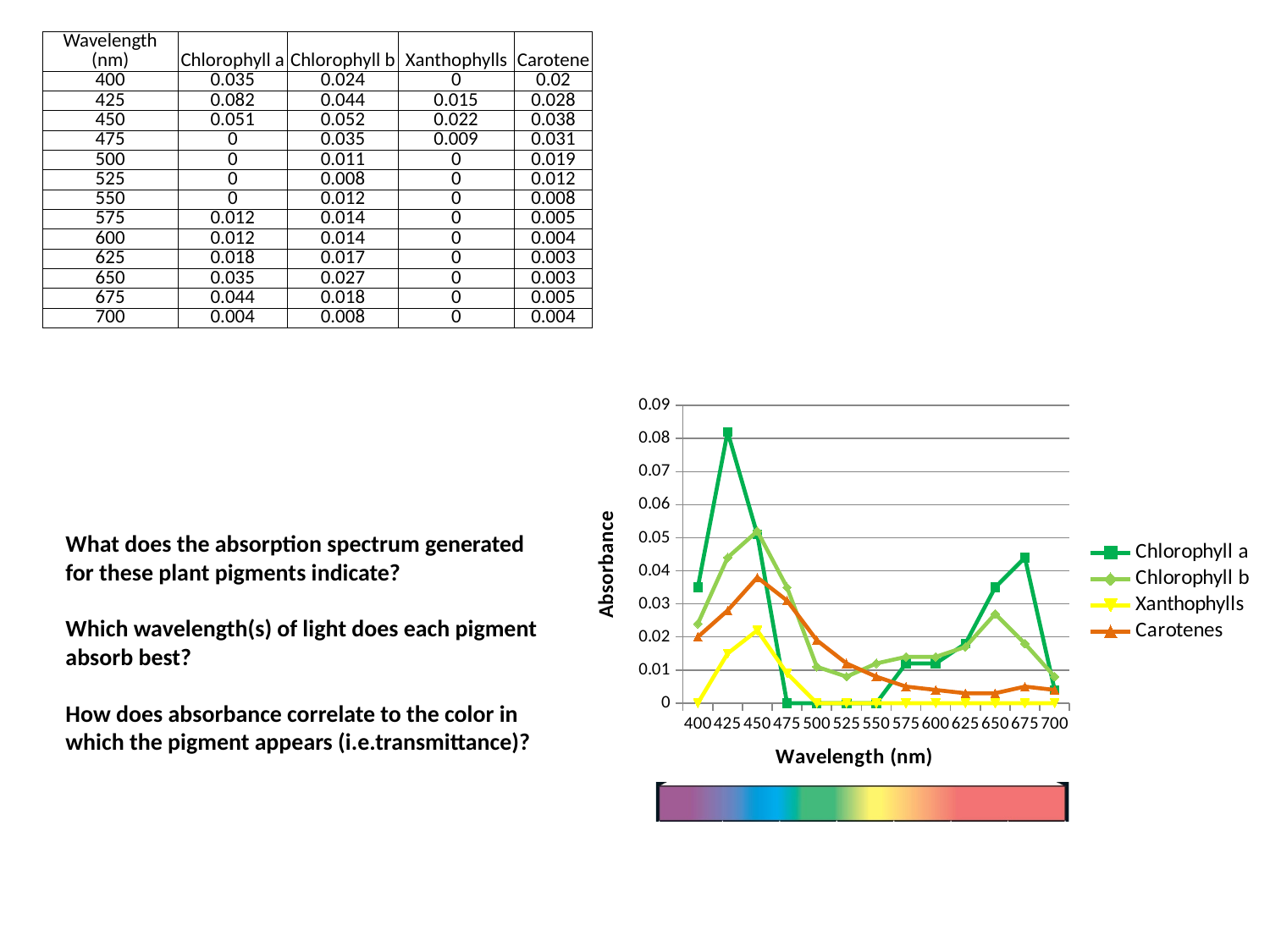
At which wavelength does Chlorophyll a reach its highest absorbance? 425 What is the absorbance of Chlorophyll a at 425 nm? 0.082 At which wavelength do Carotenes reach their highest absorbance? 450 What is the difference between the absorbance of Chlorophyll a and Chlorophyll b at 425 nm? 0.038 What is the title of the chart's vertical axis? Absorbance How many wavelength points are plotted along the x axis of the chart? 13 Is the absorbance of Chlorophyll a at 425 nm greater or less than 0.07? greater Do the Carotenes values rise or fall from 450 nm to 625 nm? fall What is the absorbance of Xanthophylls at 450 nm? 0.022 How many series does the chart's legend list? 4 At 675 nm, which has the higher absorbance, Chlorophyll a or Chlorophyll b? Chlorophyll a What kind of chart is shown on the slide? line chart